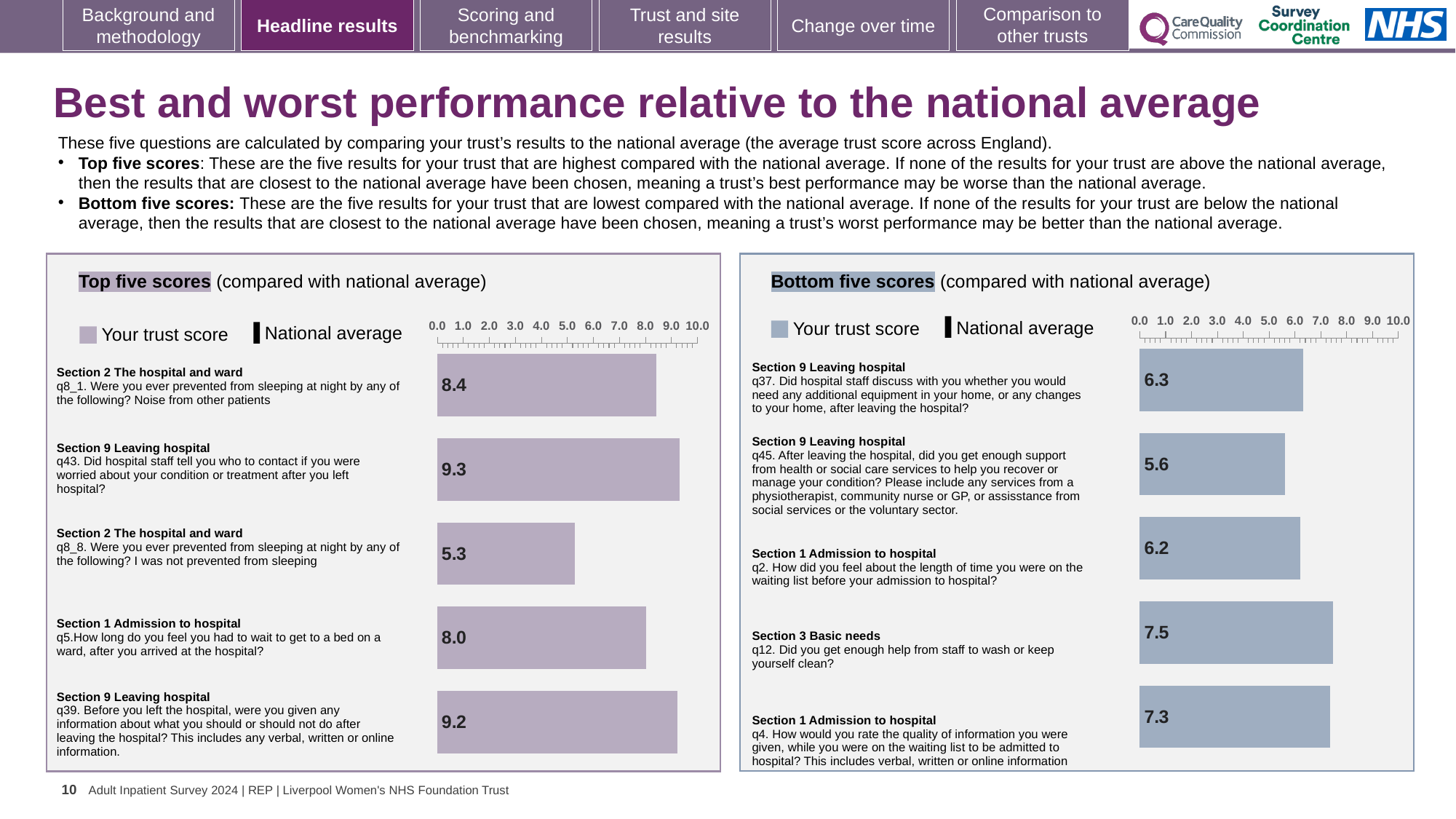
In the Bottom five scores chart, what is the difference between the trust scores for q12 and q4? 0.2 How many questions are plotted in the Bottom five scores chart? 5 In the Bottom five scores chart, what is the trust score for q45 (After leaving the hospital, did you get enough support from health or social care services?)? 5.6 In the Top five scores chart, which question has the highest trust score? q43 In the Top five scores chart, what is the trust score for q43 (Did hospital staff tell you who to contact if you were worried about your condition or treatment after you left hospital?)? 9.3 In the Top five scores chart, which has the larger trust score: q8_1 or q5? q8_1 In the Bottom five scores chart, what is the trust score for q12 (Did you get enough help from staff to wash or keep yourself clean?)? 7.5 In the Bottom five scores chart, which question has the lowest trust score? q45 What kind of chart is the Top five scores chart? Bar chart In the Top five scores chart, what is the difference between the trust scores for q43 and q8_8? 4.0 In the Top five scores chart, what is the trust score for q8_8 (I was not prevented from sleeping)? 5.3 How many series does the legend of the Bottom five scores chart list? 2